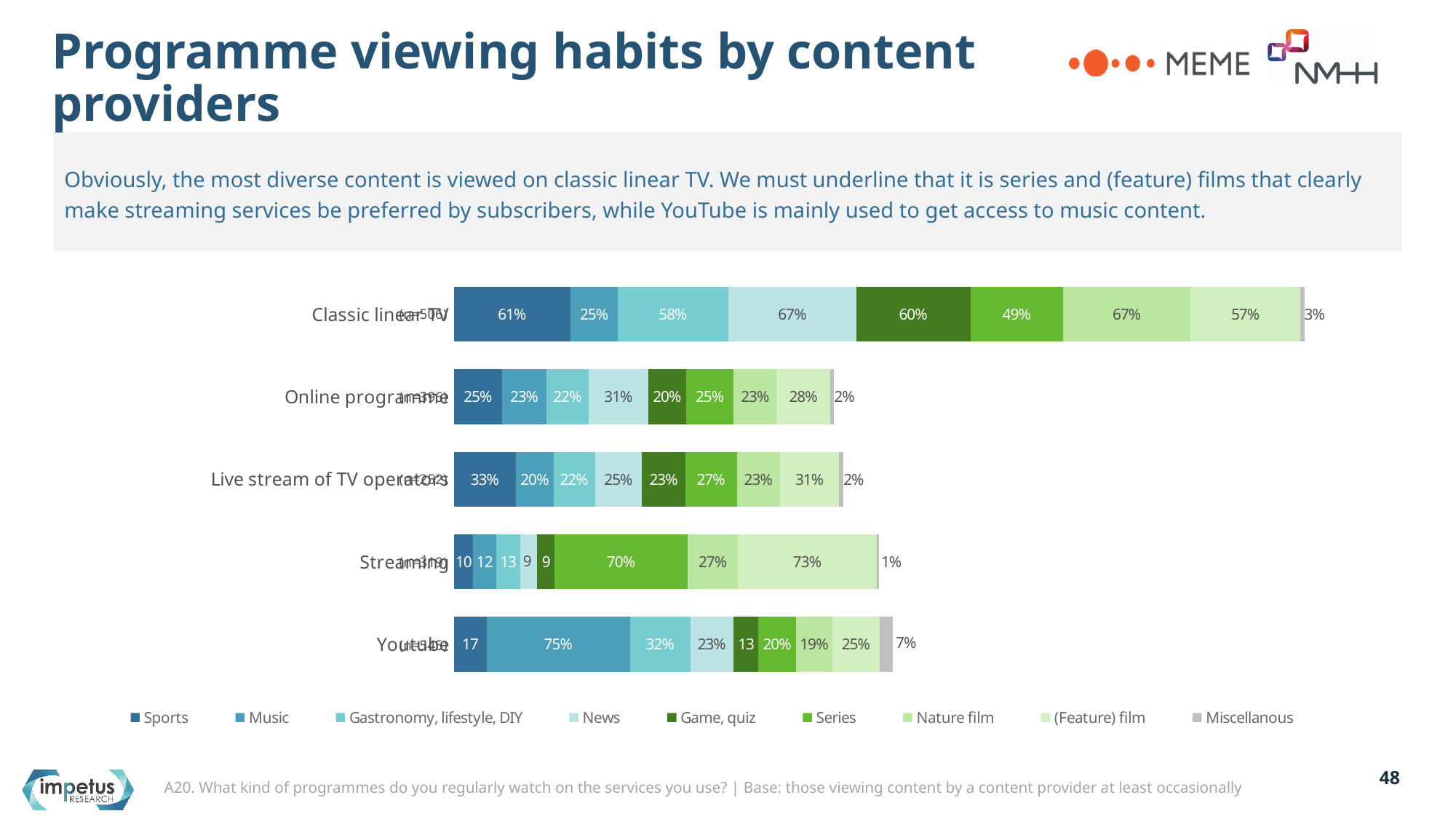
How many content providers (categories) are shown in the chart? 5 How many series does the legend list? 9 What is the (Feature) film value for Live stream of TV operators? 31% Which content provider has the highest Music value? Youtube Which is larger: the News value for Online programme or the News value for Live stream of TV operators? Online programme What is the Series value for Streaming? 70% What is the Music value for Youtube? 75% What type of chart is shown on the slide? stacked bar chart What is the difference between the (Feature) film value for Streaming and for Classic linear TV? 16% Which legend entry is shown in grey? Miscellanous What is the Sports value for Classic linear TV? 61% Which content provider has the lowest Sports value? Streaming